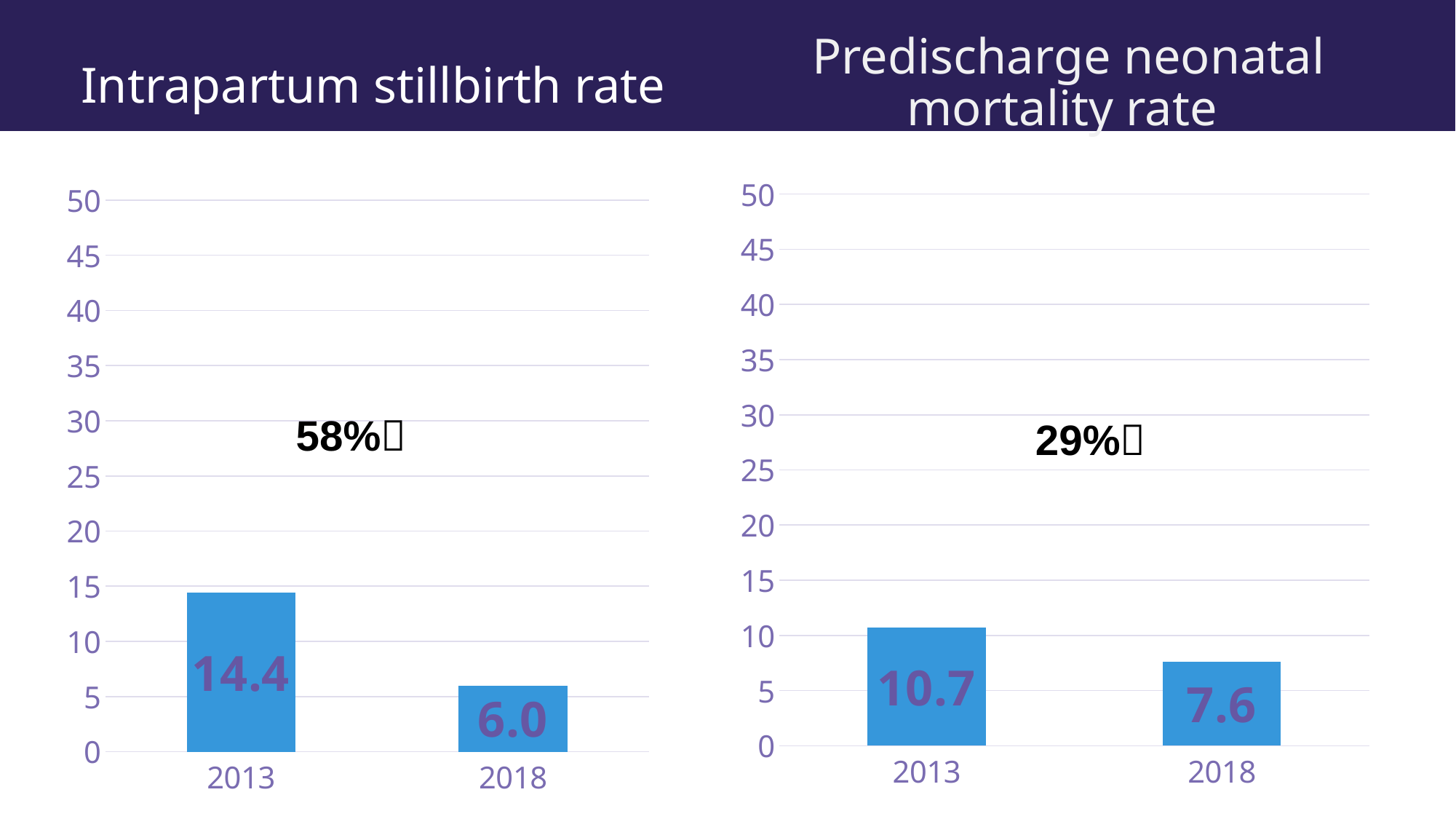
In the Intrapartum stillbirth rate chart, do the values rise or fall from 2013 to 2018? fall In the Predischarge neonatal mortality rate chart, what is the value for 2013? 10.7 In the Predischarge neonatal mortality rate chart, what is the difference between the 2013 and 2018 values? 3.1 In the Intrapartum stillbirth rate chart, what is the value for 2013? 14.4 In the Predischarge neonatal mortality rate chart, which year has the lower value? 2018 In the Predischarge neonatal mortality rate chart, what is the value for 2018? 7.6 In the Intrapartum stillbirth rate chart, what is the difference between the 2013 and 2018 values? 8.4 What kind of chart is the Predischarge neonatal mortality rate chart? bar chart What percentage decrease is annotated on the Intrapartum stillbirth rate chart? 58% In the Intrapartum stillbirth rate chart, which year has the higher value? 2013 Is the 2013 value in the Intrapartum stillbirth rate chart larger or smaller than the 2013 value in the Predischarge neonatal mortality rate chart? larger In the Intrapartum stillbirth rate chart, what is the value for 2018? 6.0